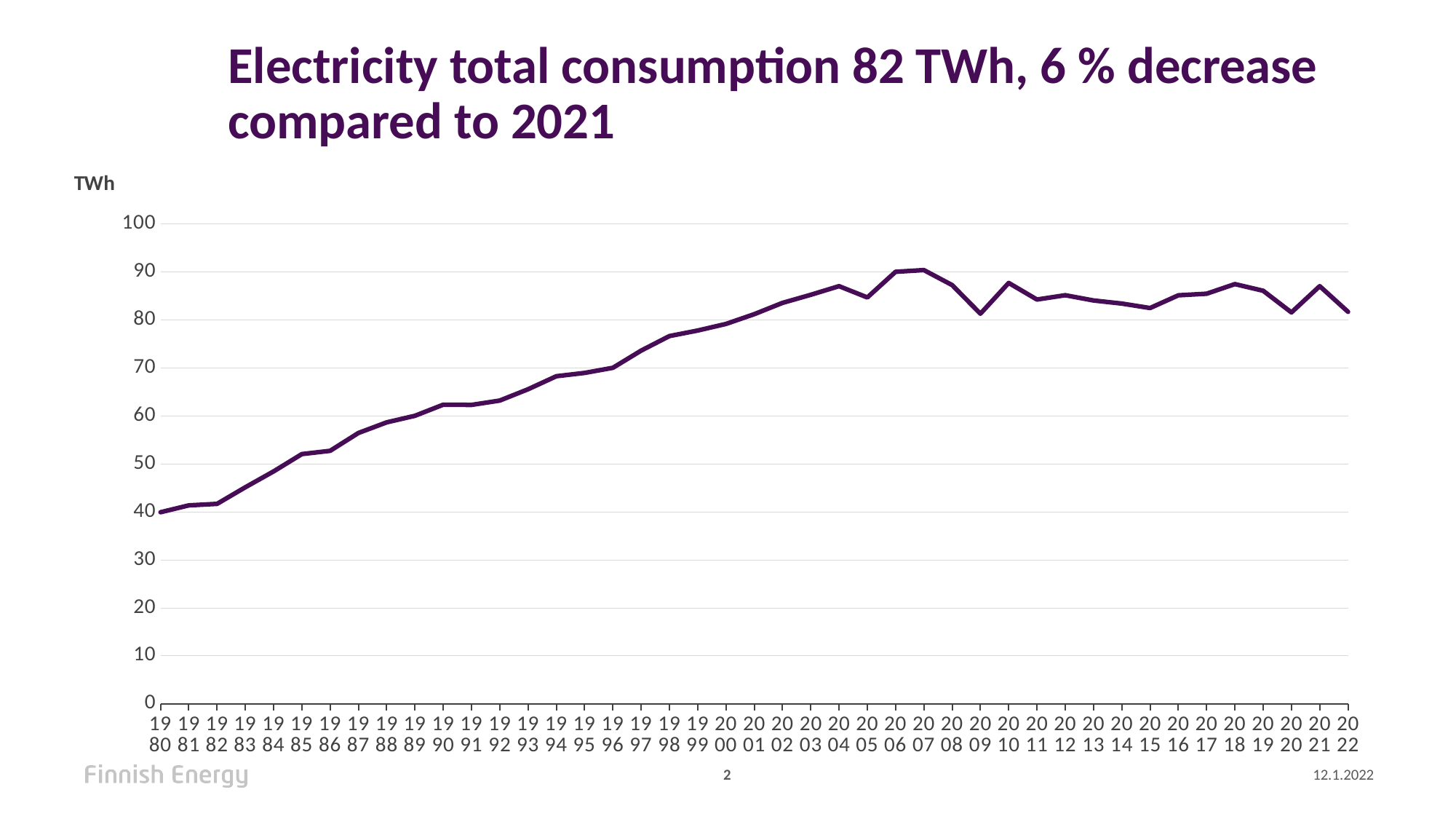
Is the value for 1985 greater or less than 50? greater Does electricity consumption generally rise or fall from 1980 to 2022? rise Which year has the higher electricity consumption, 2018 or 2020? 2018 Which year has the higher electricity consumption, 1990 or 2010? 2010 What kind of chart is shown on the slide? line chart What unit is shown on the vertical axis of the chart? TWh Which year has the lowest electricity consumption in the chart? 1980 Is the value for 1998 greater or less than 70? greater Is the value for 2004 greater or less than 80? greater According to the slide title, what was total electricity consumption in 2022? 82 TWh How many years are plotted along the x axis of the chart? 43